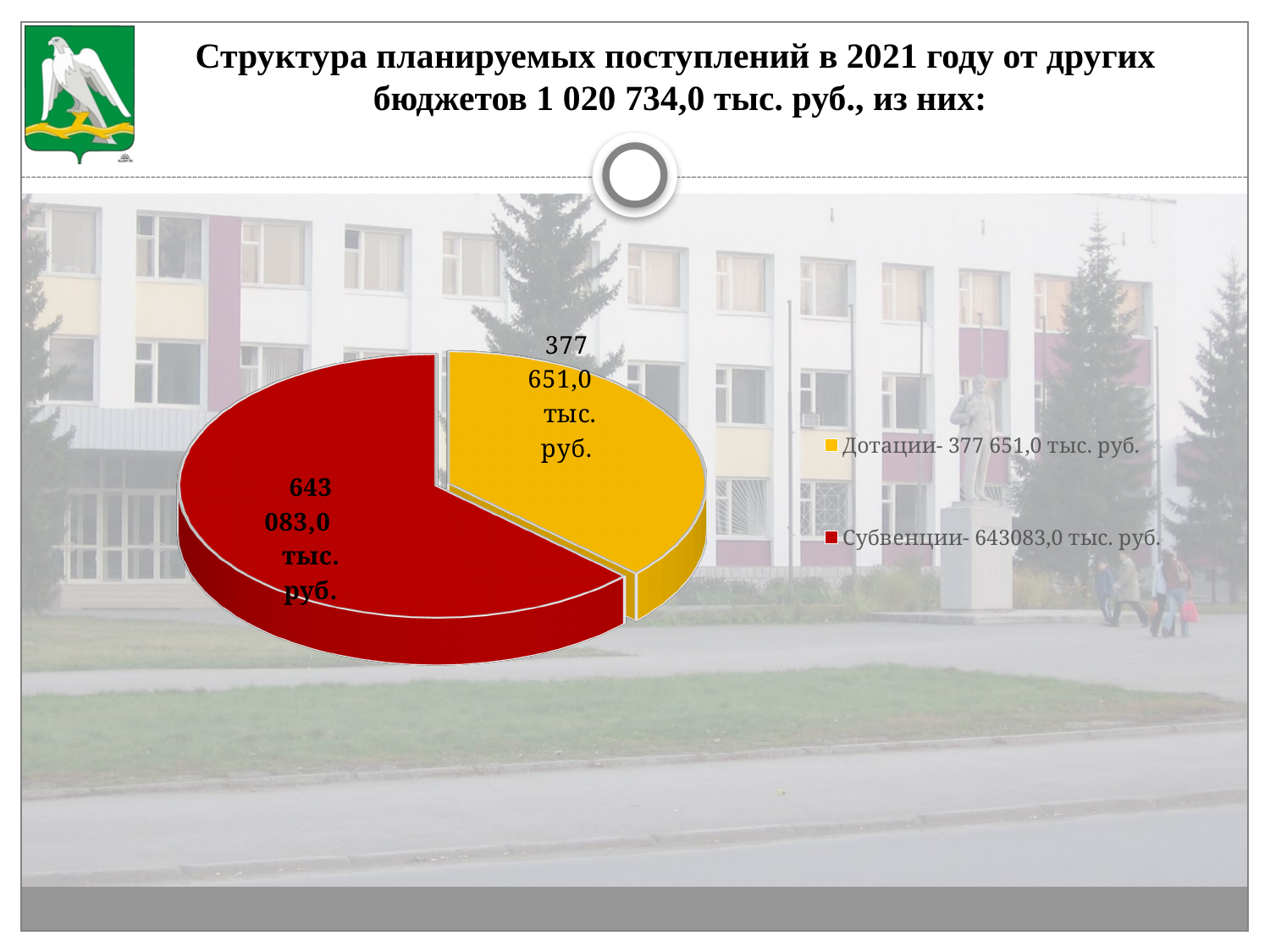
Which is larger in the pie chart, Дотации or Субвенции? Субвенции What share of the total 1 020 734,0 тыс. руб. does the Субвенции slice represent? 63% What is the value of the Дотации slice in the pie chart? 377 651,0 тыс. руб. How many slices does the pie chart have? 2 What is the value of the Субвенции slice in the pie chart? 643 083,0 тыс. руб. What kind of chart is shown on the slide? Pie chart What colour is the Дотации slice in the pie chart? Yellow How many entries does the legend of the pie chart list? 2 What share of the total 1 020 734,0 тыс. руб. does the Дотации slice represent? 37% Which category has the smallest slice in the pie chart? Дотации What is the difference between the Субвенции and Дотации values in the pie chart? 265 432,0 тыс. руб. Which category has the largest slice in the pie chart? Субвенции